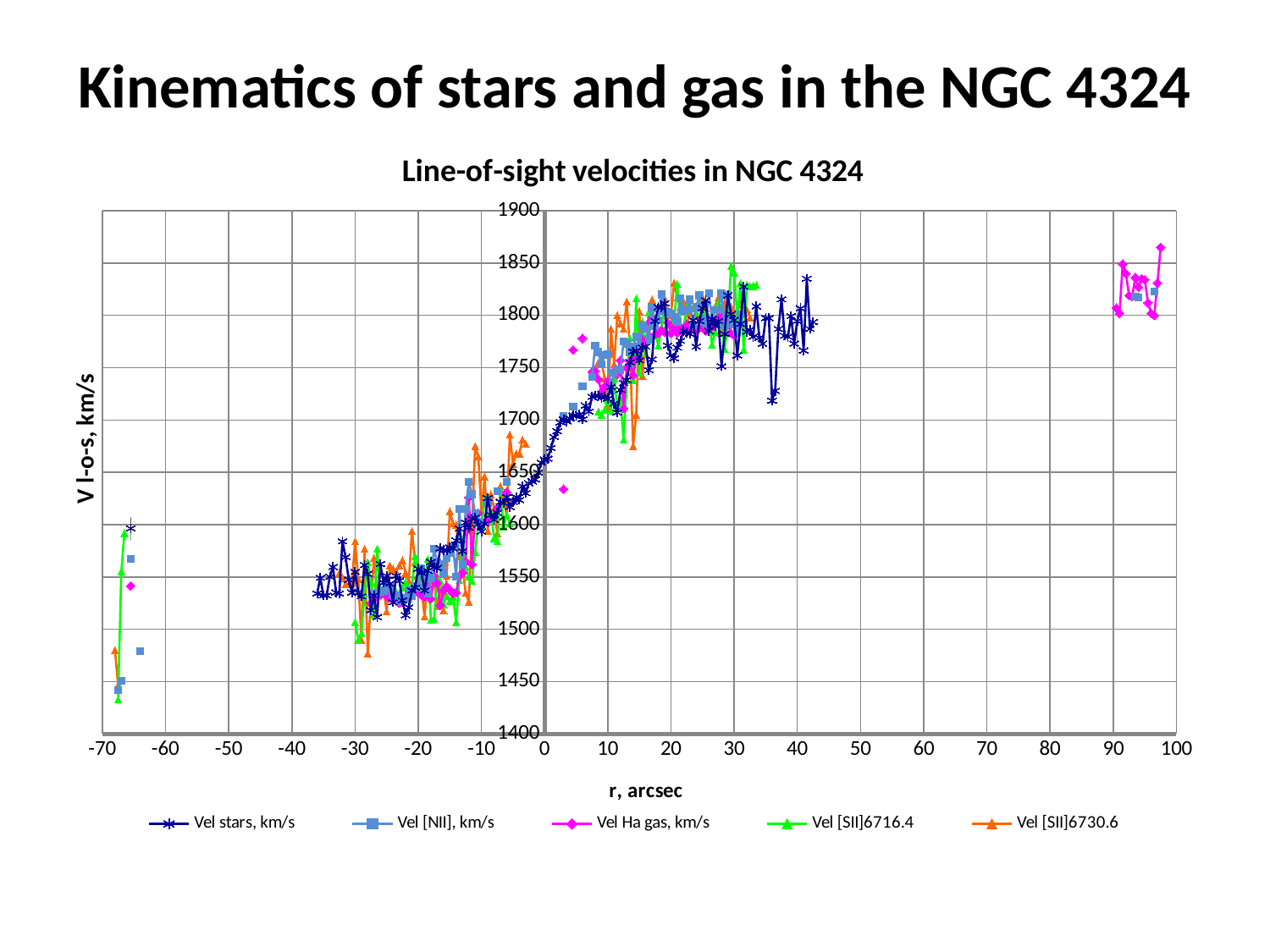
Is the value of Vel [NII], km/s at r = -67 arcsec greater or less than 1500? less How many series does the legend list? 5 Do the line-of-sight velocities generally rise or fall as r increases from -40 to 40 arcsec? rise What is the label of the x axis? r, arcsec Is the value of Vel stars, km/s at r = 0 arcsec greater or less than 1600? greater Is the value of Vel stars, km/s at r = 30 arcsec greater or less than 1700? greater What kind of chart is shown on the slide? scatter chart For Vel stars, km/s, is the value larger at r = 30 arcsec or at r = -30 arcsec? r = 30 arcsec What is the title of the chart? Line-of-sight velocities in NGC 4324